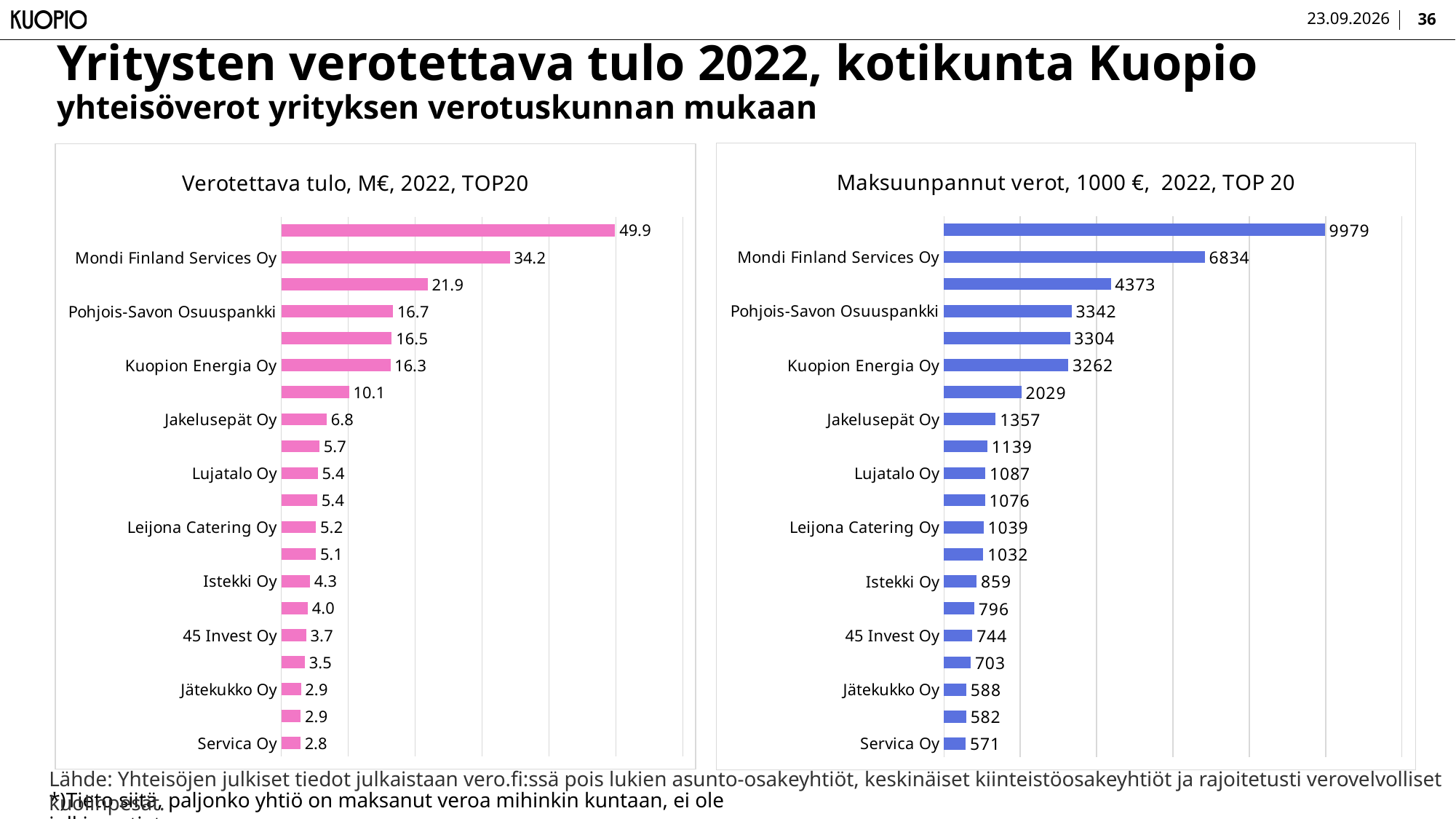
How many bars are shown in the left chart 'Verotettava tulo, M€, 2022, TOP20'? 20 In the right chart 'Maksuunpannut verot, 1000 €, 2022, TOP 20', what is the value for Kuopion Energia Oy? 3262 In the left chart 'Verotettava tulo, M€, 2022, TOP20', what is the value for Jakelusepät Oy? 6.8 In the left chart 'Verotettava tulo, M€, 2022, TOP20', what is the value for Mondi Finland Services Oy? 34.2 In the right chart 'Maksuunpannut verot, 1000 €, 2022, TOP 20', which is larger: Lujatalo Oy or Leijona Catering Oy? Lujatalo Oy In the left chart 'Verotettava tulo, M€, 2022, TOP20', what is the difference between Mondi Finland Services Oy and Pohjois-Savon Osuuspankki? 17.5 In the right chart 'Maksuunpannut verot, 1000 €, 2022, TOP 20', what is the value for Istekki Oy? 859 What kind of chart is the right chart 'Maksuunpannut verot, 1000 €, 2022, TOP 20'? Bar chart In the left chart 'Verotettava tulo, M€, 2022, TOP20', what is the largest value shown? 49.9 In the right chart 'Maksuunpannut verot, 1000 €, 2022, TOP 20', what is the difference between Mondi Finland Services Oy and Pohjois-Savon Osuuspankki? 3492 What colour are the bars in the left chart 'Verotettava tulo, M€, 2022, TOP20'? Pink In the right chart 'Maksuunpannut verot, 1000 €, 2022, TOP 20', which labelled company has the lowest value? Servica Oy